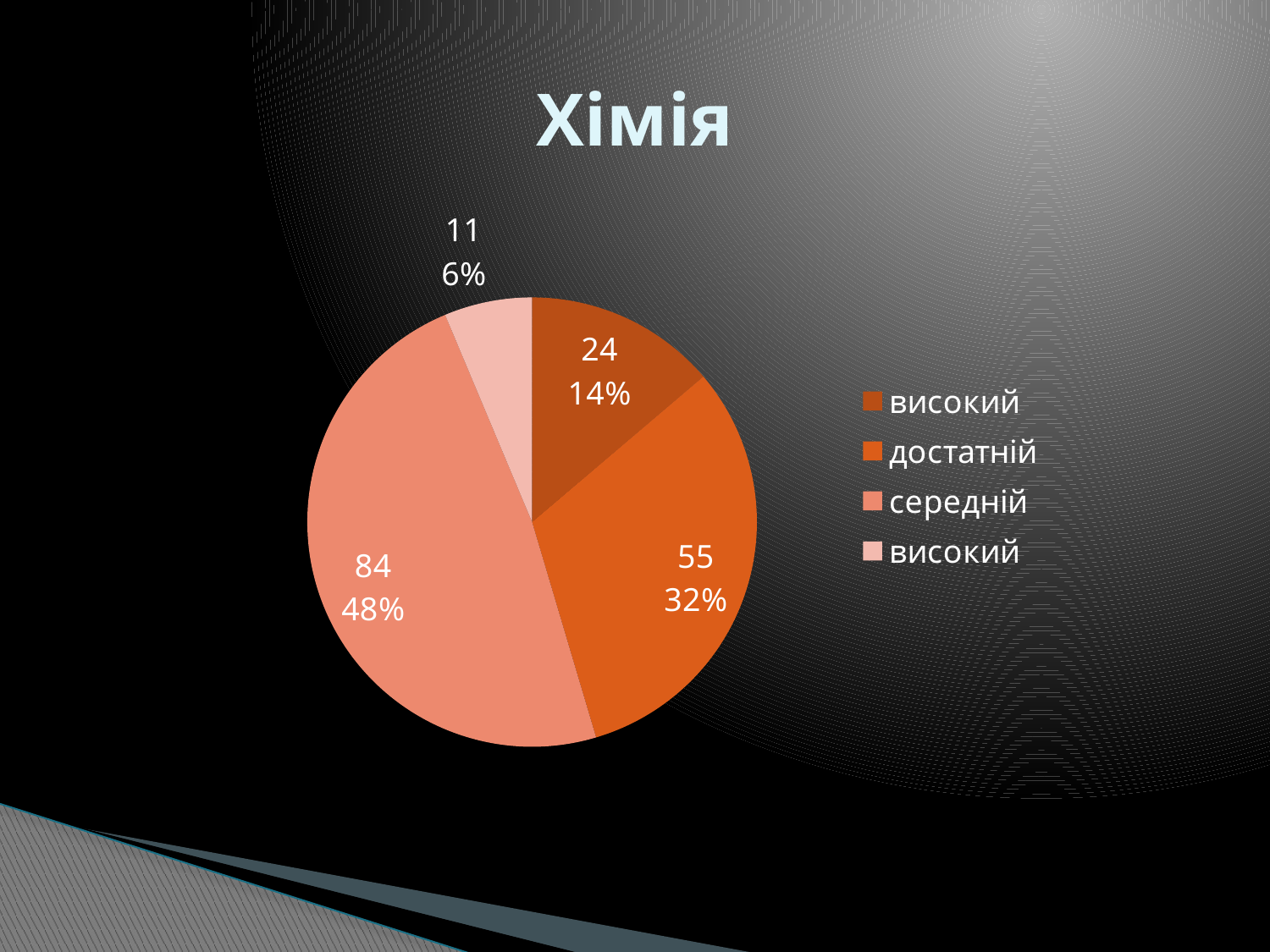
What kind of chart is shown on the slide? pie chart What is the title of the chart? Хімія What percentage share does the середній slice have? 48% Which is larger, the достатній slice or the середній slice? середній Which legend category has the largest slice? середній How many entries does the legend list? 4 What is the percentage share of the smallest slice? 6% What percentage share does the достатній slice have? 32% How many slices does the pie chart have? 4 What value is shown for the достатній slice? 55 What value is shown for the середній slice? 84 What is the difference between the середній value and the достатній value? 29